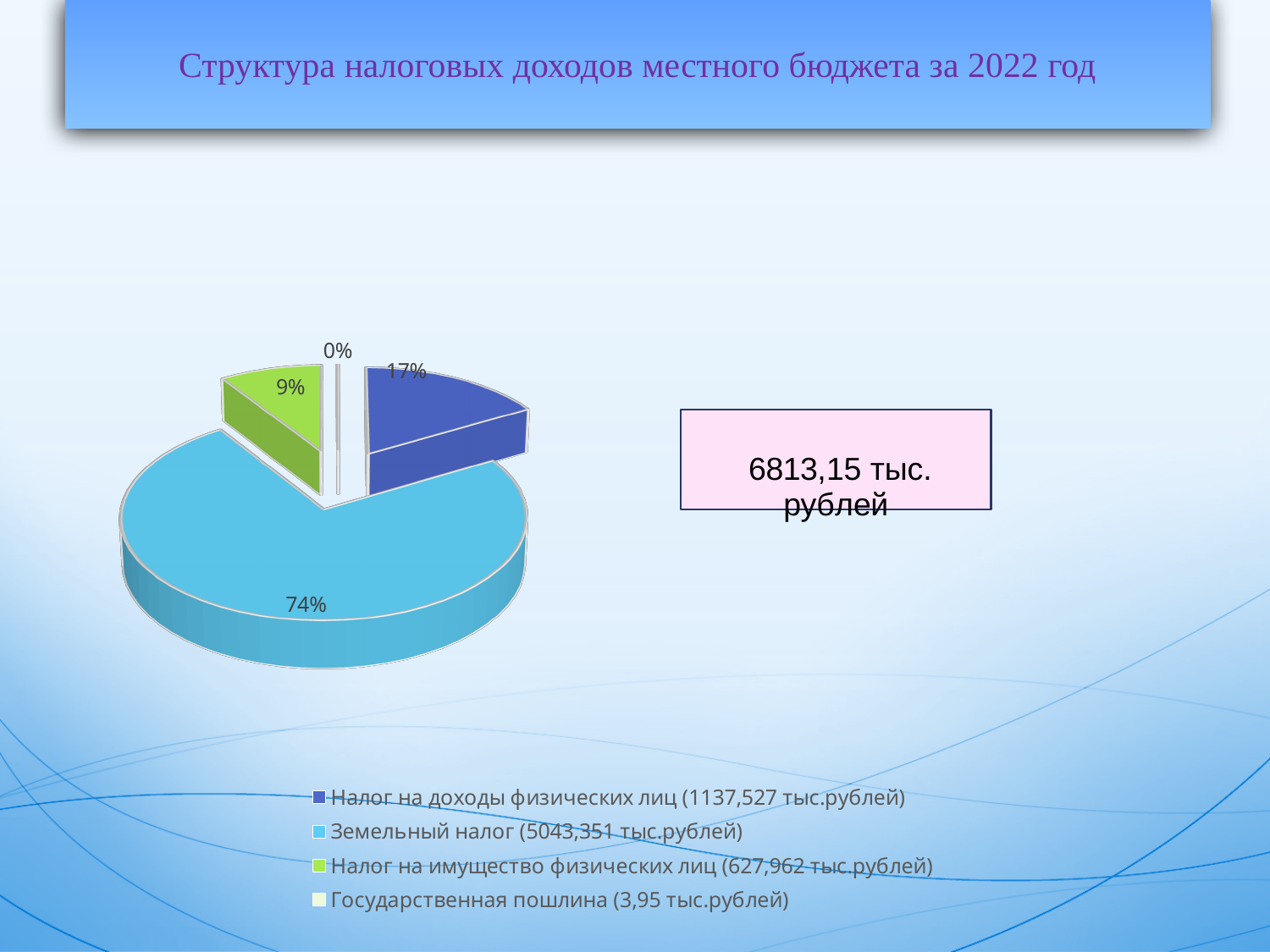
What kind of chart is shown on the slide? pie chart What is the title of the slide containing the chart? Структура налоговых доходов местного бюджета за 2022 год What is the difference in percentage points between the share for Земельный налог and the share for Налог на доходы физических лиц? 57% Which category has the largest slice of the pie? Земельный налог How many categories does the pie chart show? 4 What share of the pie does Налог на доходы физических лиц take? 17% Which is larger: the share for Налог на доходы физических лиц or the share for Налог на имущество физических лиц? Налог на доходы физических лиц What share of the pie does Государственная пошлина take? 0% Which category has the smallest slice of the pie? Государственная пошлина What amount in тыс.рублей does the legend give for Земельный налог? 5043,351 тыс.рублей What share of the pie does Земельный налог take? 74%